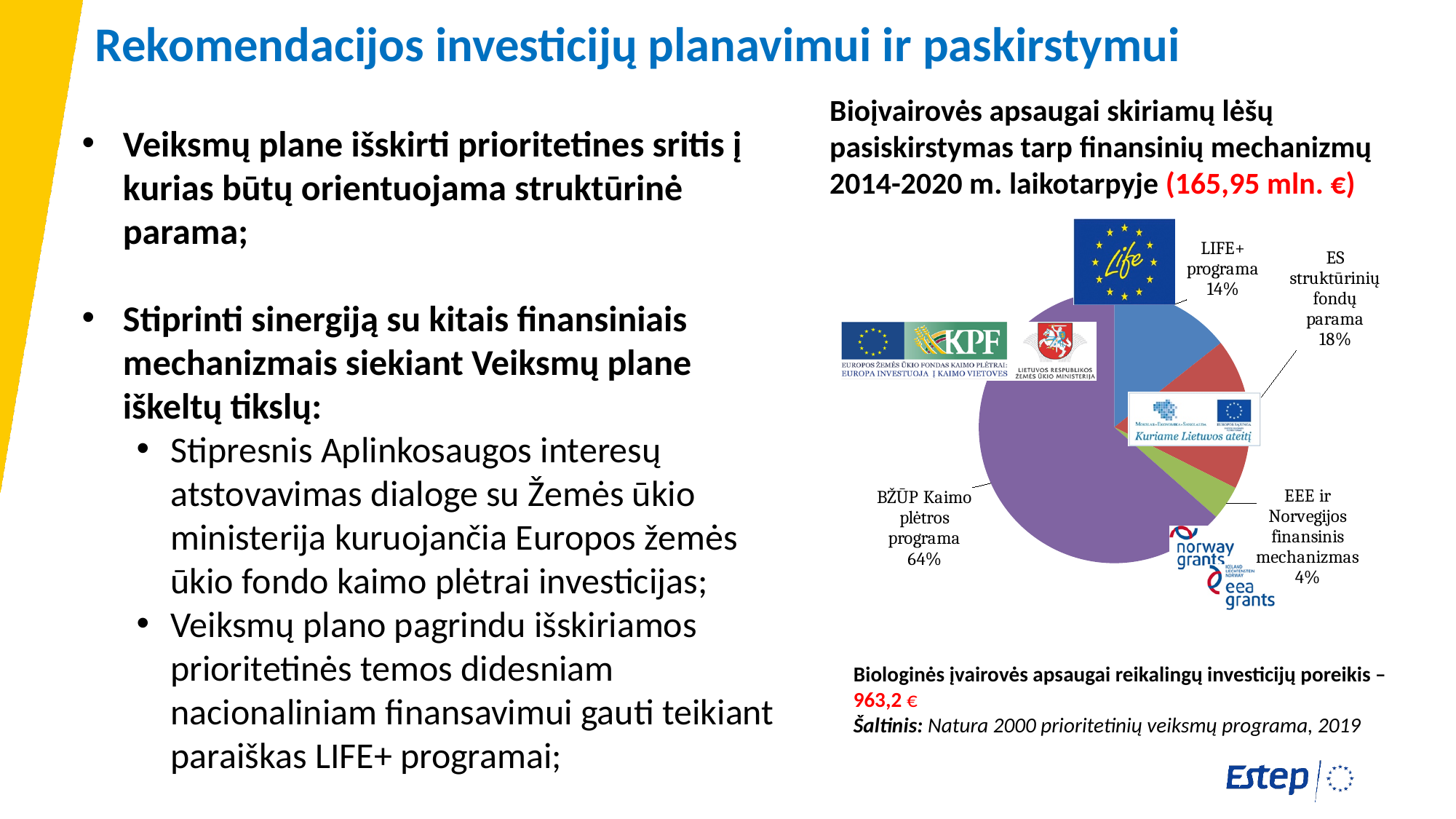
Which slice of the pie chart is the largest? BŽŪP Kaimo plėtros programa What total amount in million euros is stated in the chart title? 165,95 mln. € What share of the pie does the ES struktūrinių fondų parama slice represent? 18% What share of the pie does the EEE ir Norvegijos finansinis mechanizmas slice represent? 4% Which slice of the pie chart is the smallest? EEE ir Norvegijos finansinis mechanizmas What period does the chart title say the distribution covers? 2014-2020 m. What is the difference in percentage points between the ES struktūrinių fondų parama slice and the LIFE+ programa slice? 4 What kind of chart is shown on the slide? Pie chart Which is larger: the LIFE+ programa slice or the ES struktūrinių fondų parama slice? ES struktūrinių fondų parama What share of the pie does the BŽŪP Kaimo plėtros programa slice represent? 64% How many slices does the pie chart have? 4